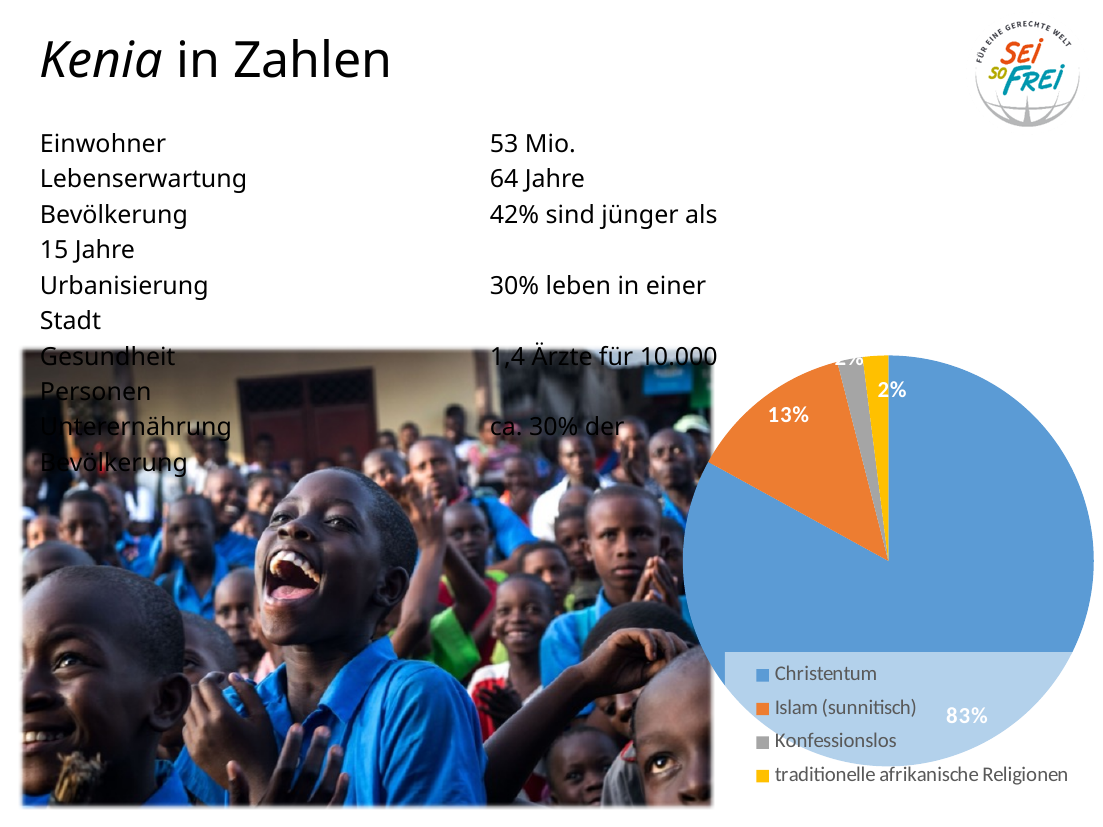
What share of the pie chart does Christentum have? 83% What is the difference in percentage points between the Christentum and Islam (sunnitisch) slices? 70 What share of the pie chart do traditionelle afrikanische Religionen have? 2% What share of the pie chart does Islam (sunnitisch) have? 13% What colour is the Islam (sunnitisch) slice in the pie chart? orange What kind of chart is shown on the slide? pie chart How many categories does the legend of the pie chart list? 4 Which legend entry of the pie chart is shown in yellow? traditionelle afrikanische Religionen Is the share for Christentum greater or less than 50%? greater Which category has the largest slice in the pie chart? Christentum Is the share for Islam (sunnitisch) greater or less than 25%? less Which is larger in the pie chart, Christentum or Islam (sunnitisch)? Christentum